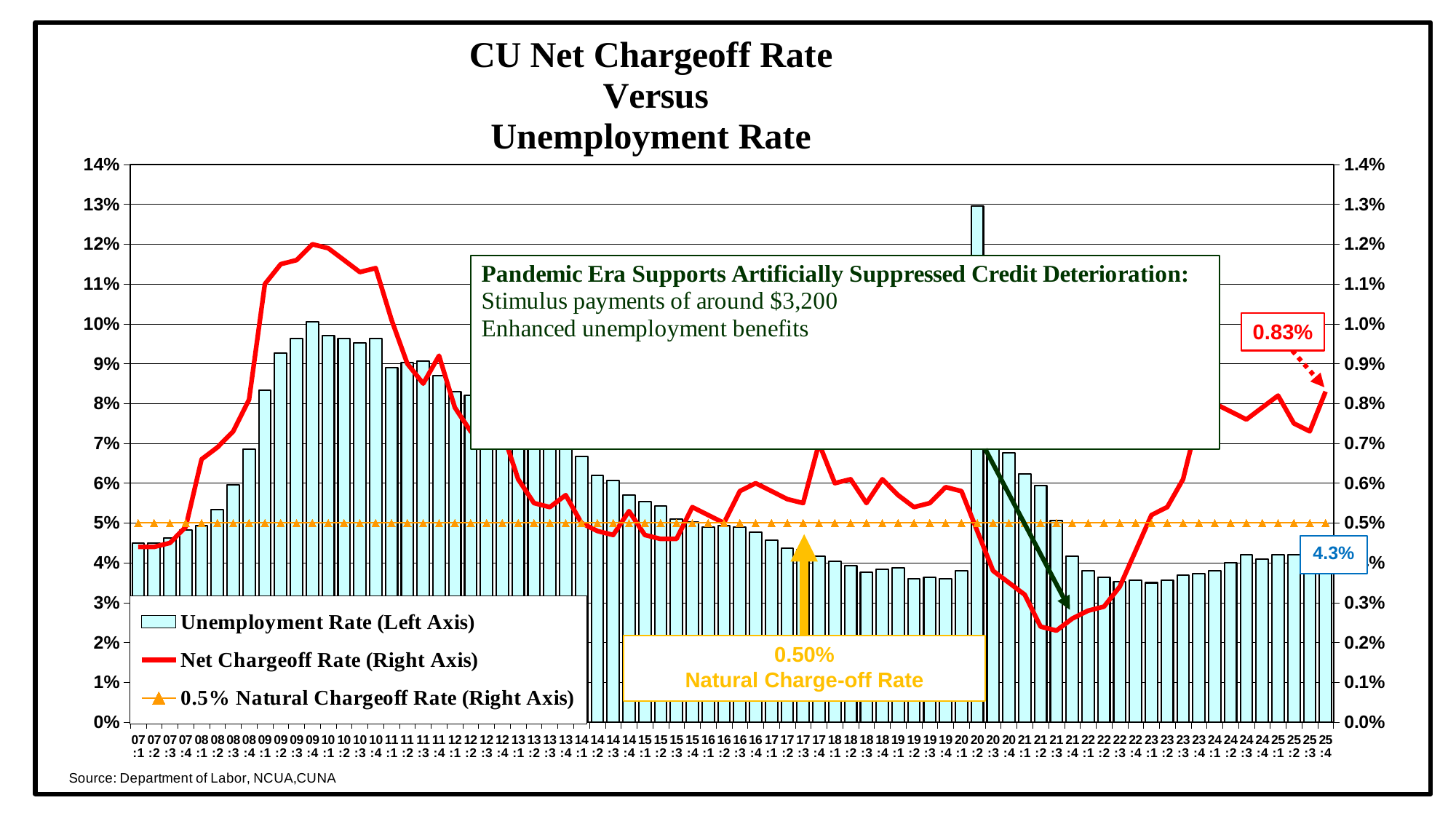
At 25:4, is the Net Chargeoff Rate above or below the 0.5% Natural Chargeoff Rate line? above Is the Net Chargeoff Rate for 21:3 greater or less than 0.3%? less What value is the Natural Charge-off Rate line set at? 0.50% Is the Net Chargeoff Rate for 09:4 greater or less than 1.1%? greater What is the title of the chart? CU Net Chargeoff Rate Versus Unemployment Rate How many series does the legend list? 3 In which quarter is the Unemployment Rate bar the highest? 20:2 What kind of chart is shown on the slide? A combined bar and line chart Does the Unemployment Rate generally rise or fall from 10:1 to 19:4? fall Is the Unemployment Rate for 20:2 greater or less than 12%? greater What is the Unemployment Rate labelled at the end of the series (25:4)? 4.3% What is the Net Chargeoff Rate labelled at the end of the series (25:4)? 0.83%